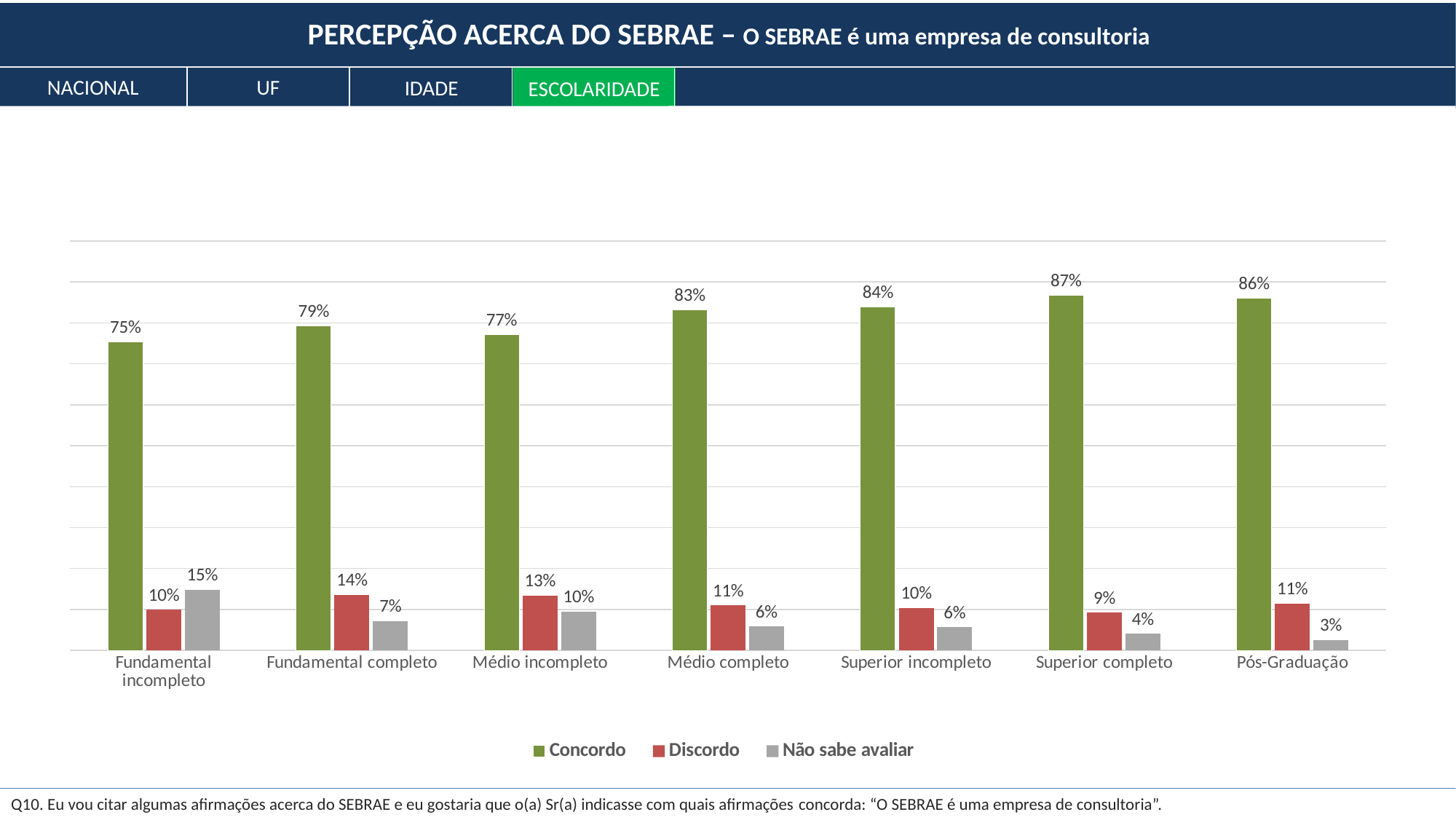
How many education categories are shown on the x axis? 7 What is the Não sabe avaliar value for Fundamental incompleto? 15% What is the Concordo value for Superior completo? 87% Which category has the lowest Não sabe avaliar value? Pós-Graduação Does the Não sabe avaliar value generally rise or fall from Fundamental incompleto to Pós-Graduação? Fall What is the Discordo value for Médio incompleto? 13% Which category has the highest Concordo value? Superior completo What kind of chart is shown on the slide? Bar chart How many series does the legend list? 3 Which is larger, the Discordo value for Fundamental completo or for Superior completo? Fundamental completo Which colour represents the Discordo series in the legend? Red What is the difference between the Concordo values for Pós-Graduação and Fundamental incompleto? 11%